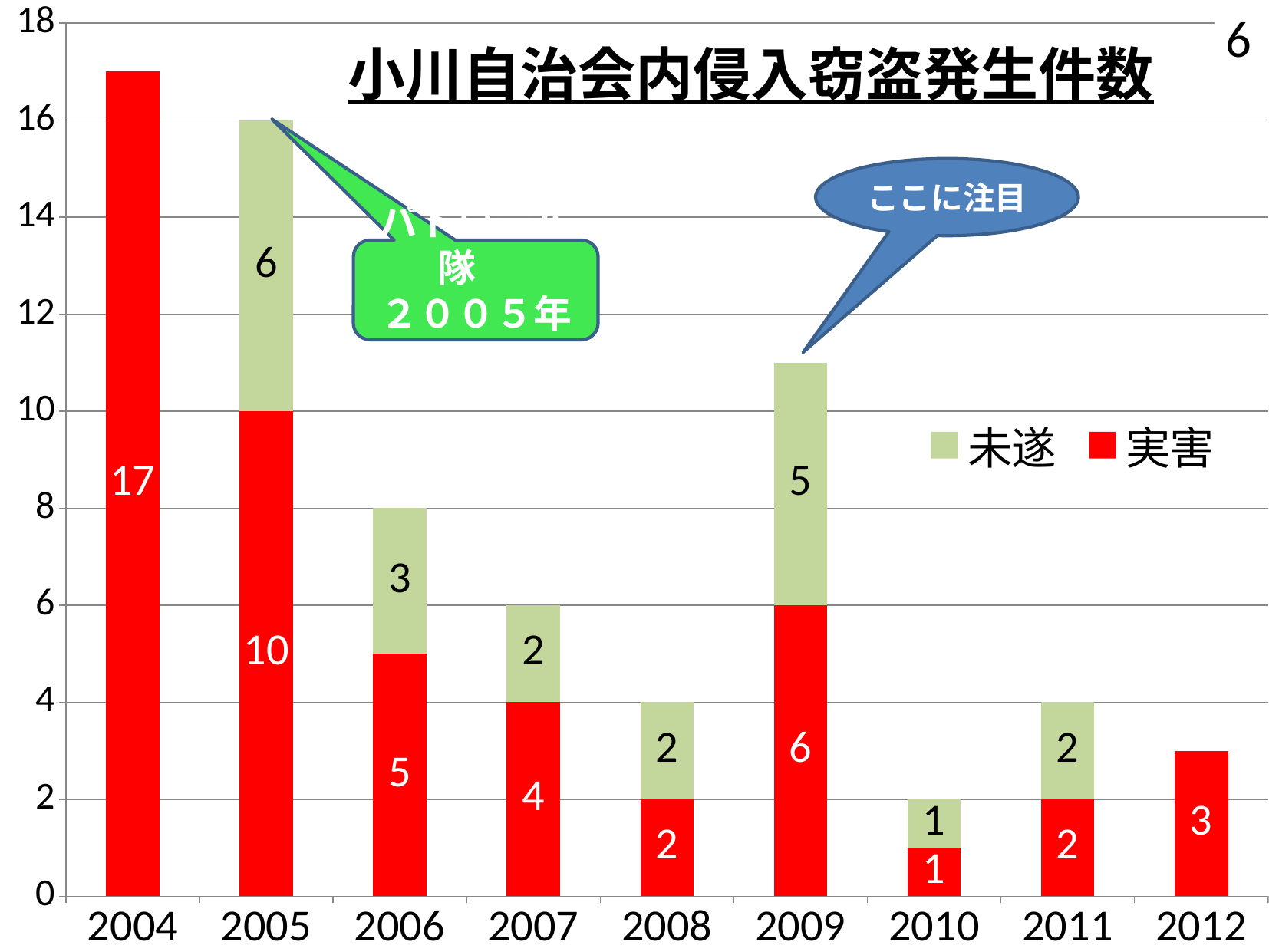
What is the difference between the 実害 values for 2005 and 2009? 4 Which year has the lowest 実害 value? 2010 Which is larger, the 未遂 value for 2006 or the 未遂 value for 2009? 2009 What is the 実害 value for 2004? 17 What kind of chart is shown on the slide? Stacked bar chart What is the total of the stacked bar for 2005? 16 How many series does the legend list? 2 How many years are shown on the x axis? 9 What is the total of the stacked bar for 2009? 11 What is the 実害 value for 2006? 5 Which year has the highest 実害 value? 2004 What is the 未遂 value for 2009? 5